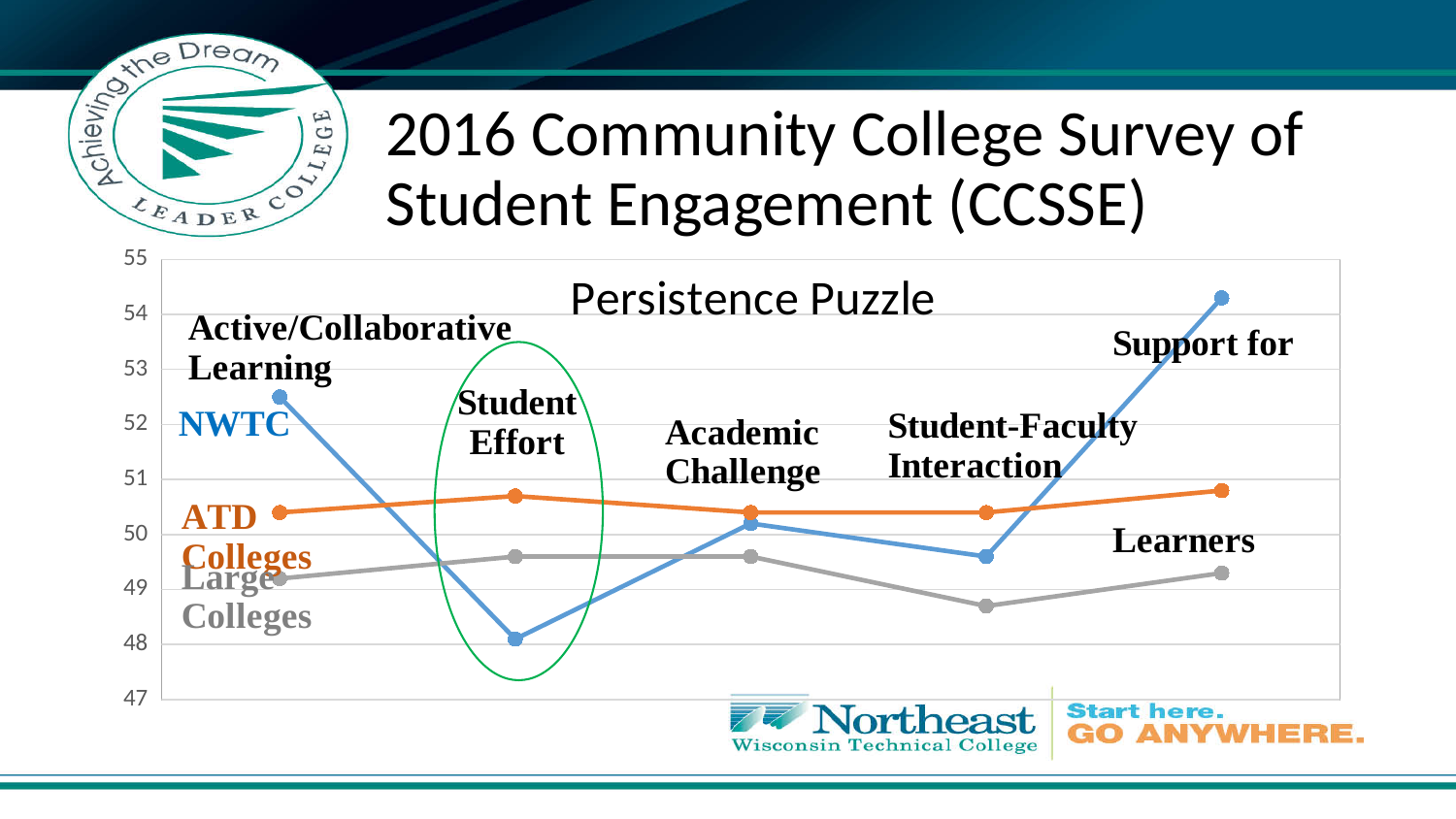
Is the NWTC value for Student Effort greater or less than 49? less For which category is the NWTC value lowest? Student Effort Does the NWTC line rise or fall from Student-Faculty Interaction to Support for Learners? rises For Student Effort, which is larger: the NWTC value or the ATD Colleges value? ATD Colleges What is the title of the chart? Persistence Puzzle How many categories are plotted along the x axis of the chart? 5 Is the NWTC value for Support for Learners greater or less than 53? greater Which series is drawn in orange? ATD Colleges How many series (lines) are plotted on the chart? 3 What kind of chart is shown on the slide? Line chart For which category is the Large Colleges value lowest? Student-Faculty Interaction For which category is the NWTC value highest? Support for Learners